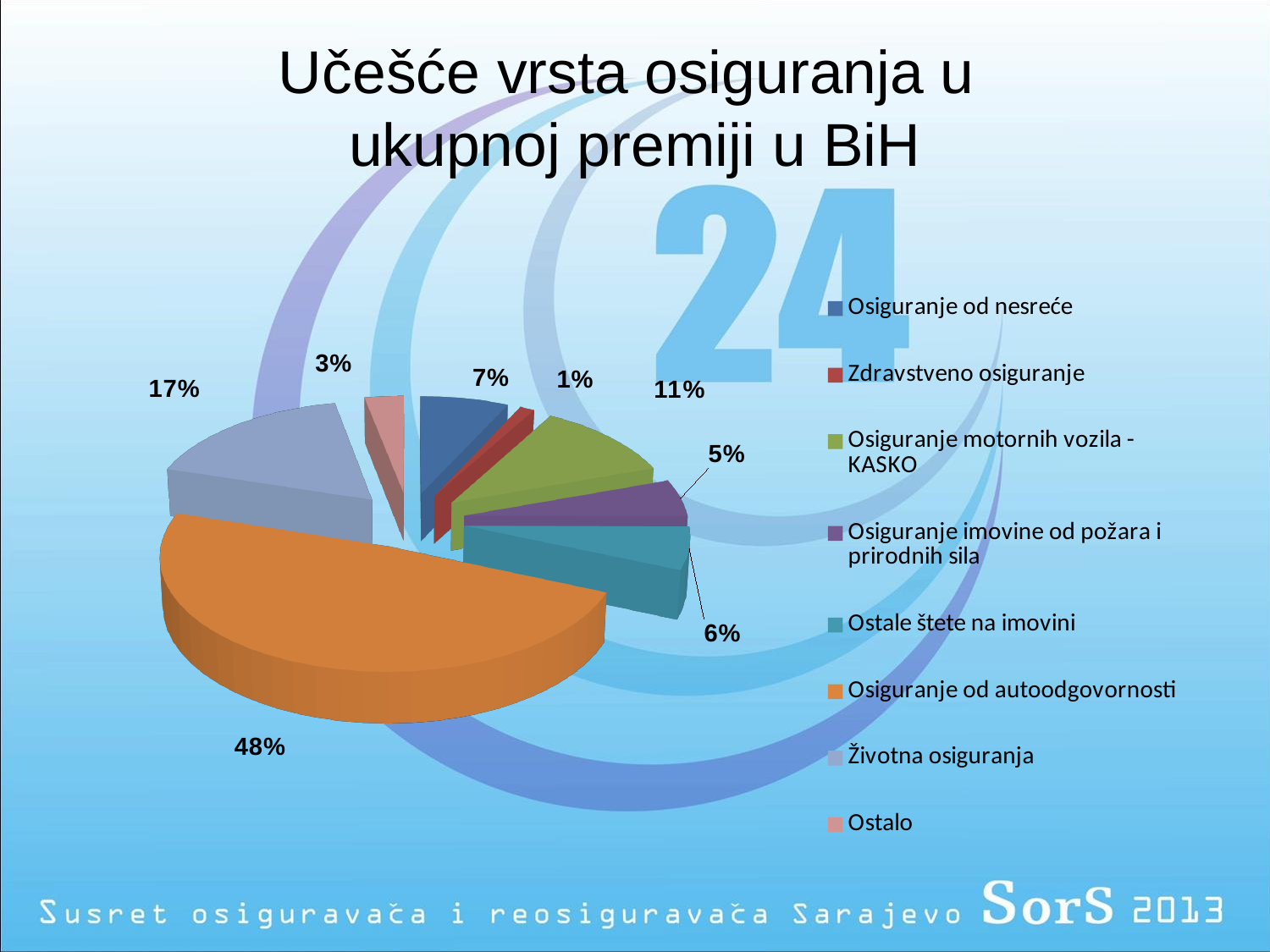
What is the difference in percentage points between Osiguranje od autoodgovornosti and Životna osiguranja? 31 Which has a larger share, Osiguranje od nesreće or Osiguranje imovine od požara i prirodnih sila? Osiguranje od nesreće What kind of chart is shown on the slide? pie chart What share does Zdravstveno osiguranje have? 1% What share does Ostale štete na imovini have? 6% What colour is the slice for Osiguranje od autoodgovornosti? orange Which type of insurance has the largest share of the total premium? Osiguranje od autoodgovornosti What share of the total premium does Osiguranje od autoodgovornosti have? 48% How many categories does the pie chart have? 8 What share of the total premium does Životna osiguranja have? 17% Which type of insurance has the smallest share of the total premium? Zdravstveno osiguranje What share does Osiguranje motornih vozila - KASKO have? 11%